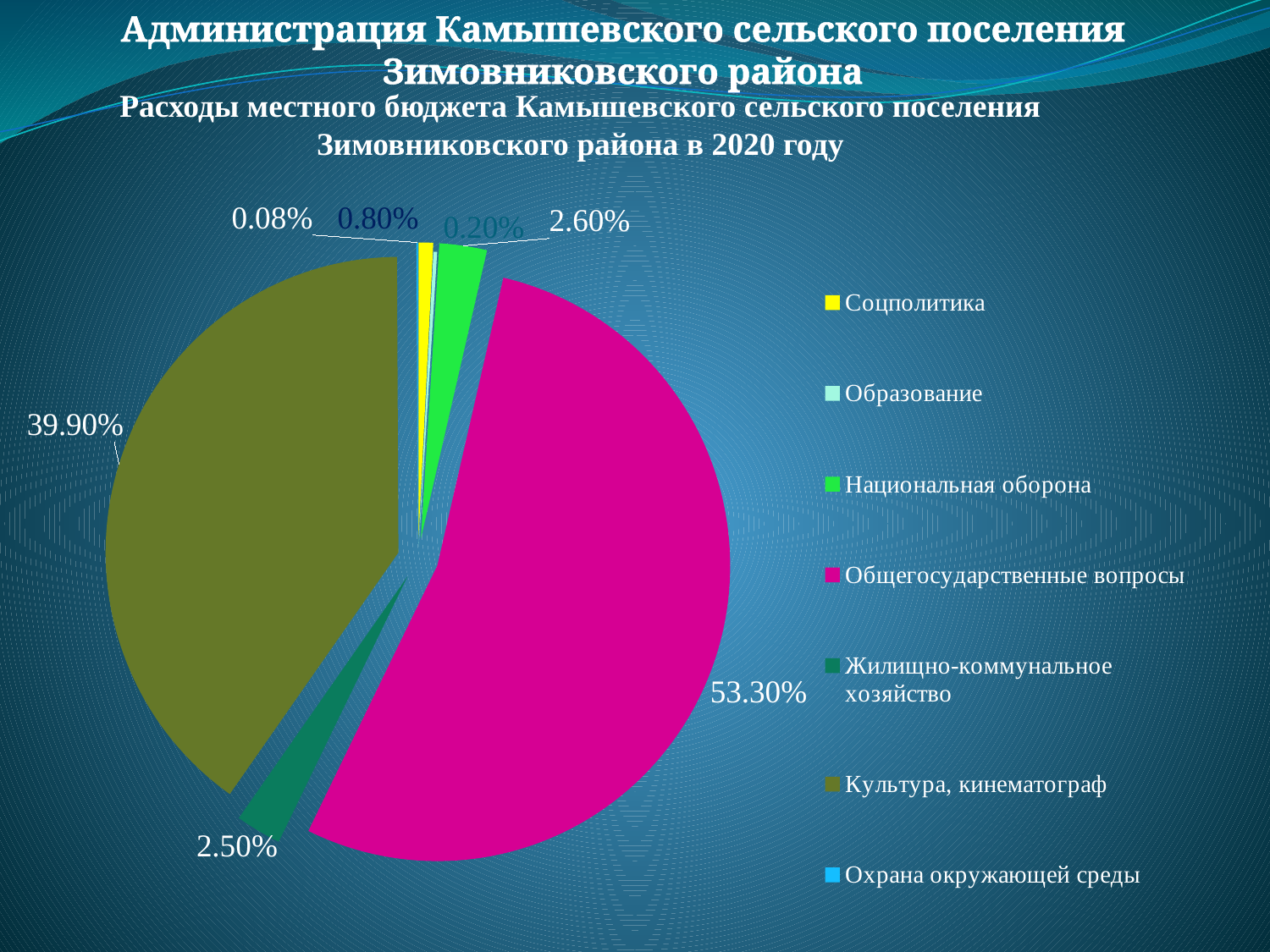
What is the smallest percentage shown on the pie chart? 0.08% How many categories does the legend list? 7 What share of the budget expenses goes to Жилищно-коммунальное хозяйство? 2.50% What share of the budget expenses goes to Культура, кинематограф? 39.90% What is the difference between the shares of Общегосударственные вопросы and Культура, кинематограф? 13.40% What share of the budget expenses goes to Общегосударственные вопросы? 53.30% What kind of chart is shown on the slide? pie chart Which category has the largest share of the pie? Общегосударственные вопросы Which is larger: the share of Национальная оборона or the share of Жилищно-коммунальное хозяйство? Национальная оборона What share of the budget expenses goes to Национальная оборона? 2.60% What colour is the slice for Общегосударственные вопросы? magenta What is the title of the chart? Расходы местного бюджета Камышевского сельского поселения Зимовниковского района в 2020 году